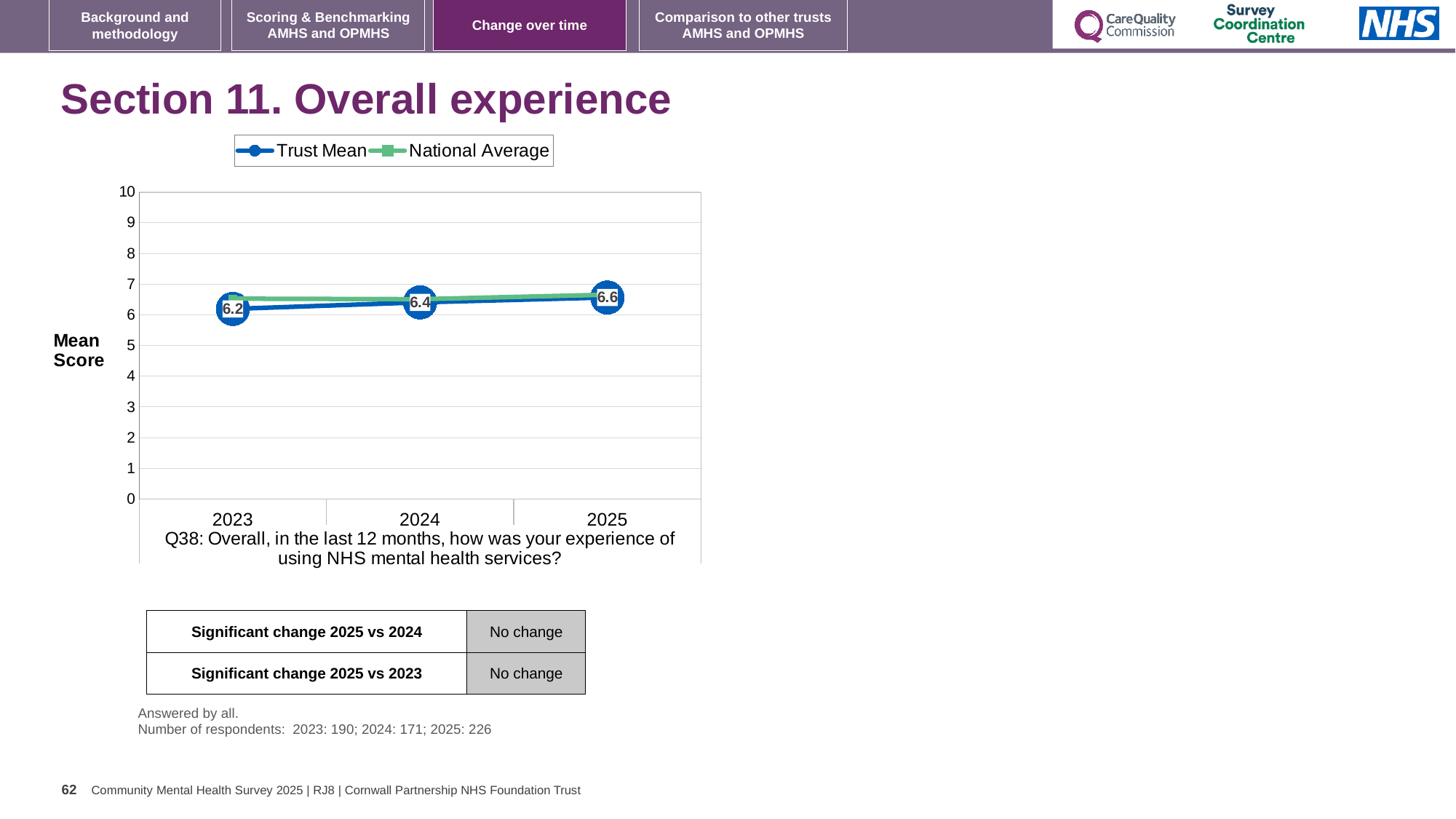
Which is larger, the Trust Mean in 2024 or in 2025? 2025 What is the difference between the Trust Mean in 2025 and in 2023? 0.4 What is the Trust Mean score for 2023? 6.2 Is the National Average value for 2025 greater or less than 7? less Does the Trust Mean rise or fall from 2023 to 2025? rise How many series does the legend list? 2 How many years are plotted on the x axis? 3 What is the Trust Mean score for 2025? 6.6 In which year is the Trust Mean lowest? 2023 What is the Trust Mean score for 2024? 6.4 In which year is the Trust Mean highest? 2025 Is the National Average value for 2023 greater or less than 6? greater